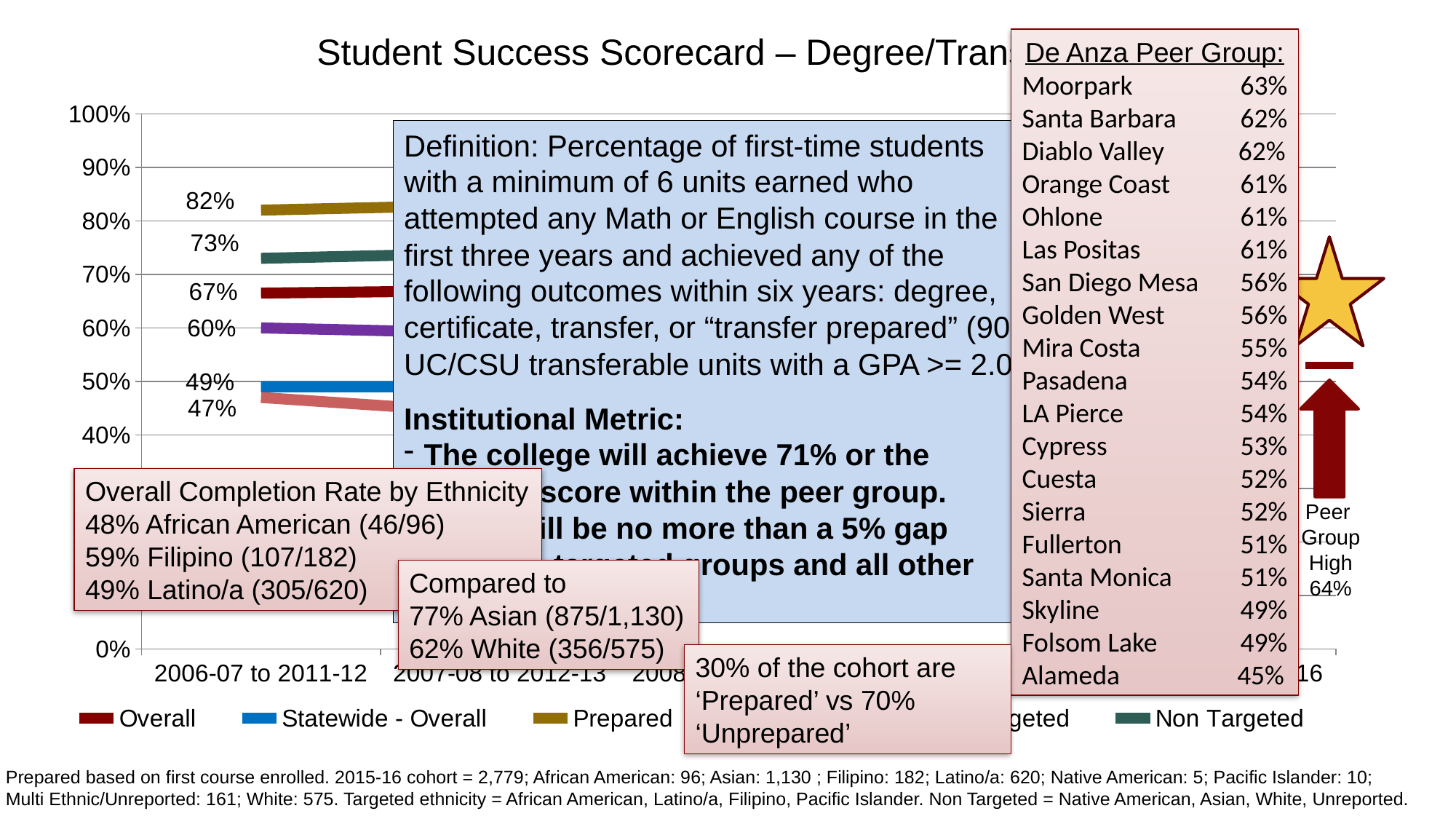
What is the first category label on the x axis? 2006-07 to 2011-12 What is the value of the Statewide - Overall series for 2006-07 to 2011-12? 49% What colour is the Overall series line in the legend? dark red For 2006-07 to 2011-12, which is larger: Overall or Statewide - Overall? Overall What is the value of the Overall series for 2006-07 to 2011-12? 67% What type of chart is shown on the slide? line chart What is the value of the Prepared series for 2006-07 to 2011-12? 82% What is the lowest data label shown for 2006-07 to 2011-12? 47% What is the difference between the Prepared and Overall values for 2006-07 to 2011-12? 15 percentage points Which series has the highest value for 2006-07 to 2011-12? Prepared Is the Non Targeted value for 2006-07 to 2011-12 greater or less than 70%? greater What is the value of the Non Targeted series for 2006-07 to 2011-12? 73%